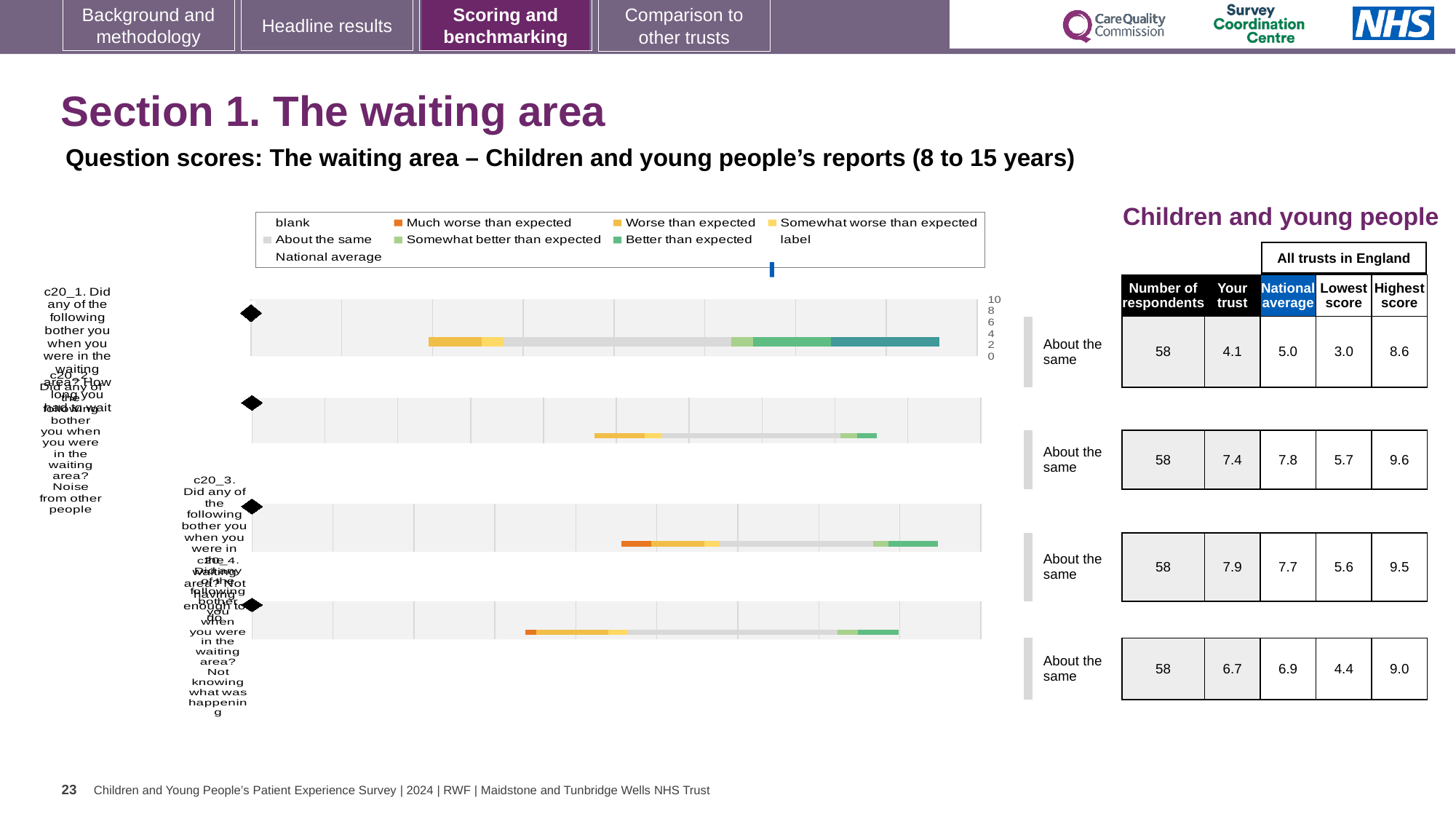
In the table to the right of the charts, what is the 'Your trust' score for the first question (c20_1)? 4.1 In the table to the right of the charts, what is the difference between the highest score (9.6) and the lowest score (5.7) for the second question (c20_2)? 3.9 In the table to the right of the charts, what is the national average for the second question (c20_2)? 7.8 In the legend, which colour represents 'Much worse than expected'? orange In the table to the right of the charts, which question has the highest 'Your trust' score? c20_3 In the table to the right of the charts, how many respondents answered each question? 58 In the table to the right of the charts, which question has the lowest 'Your trust' score? c20_1 What benchmark category is shown beside each of the four bar charts? About the same In the legend, which colour represents 'About the same'? grey How many separate bar charts (one per question) are shown on the slide? 4 What kind of chart is used to show the question scores on this slide? bar chart How many entries does the legend above the charts list? 9